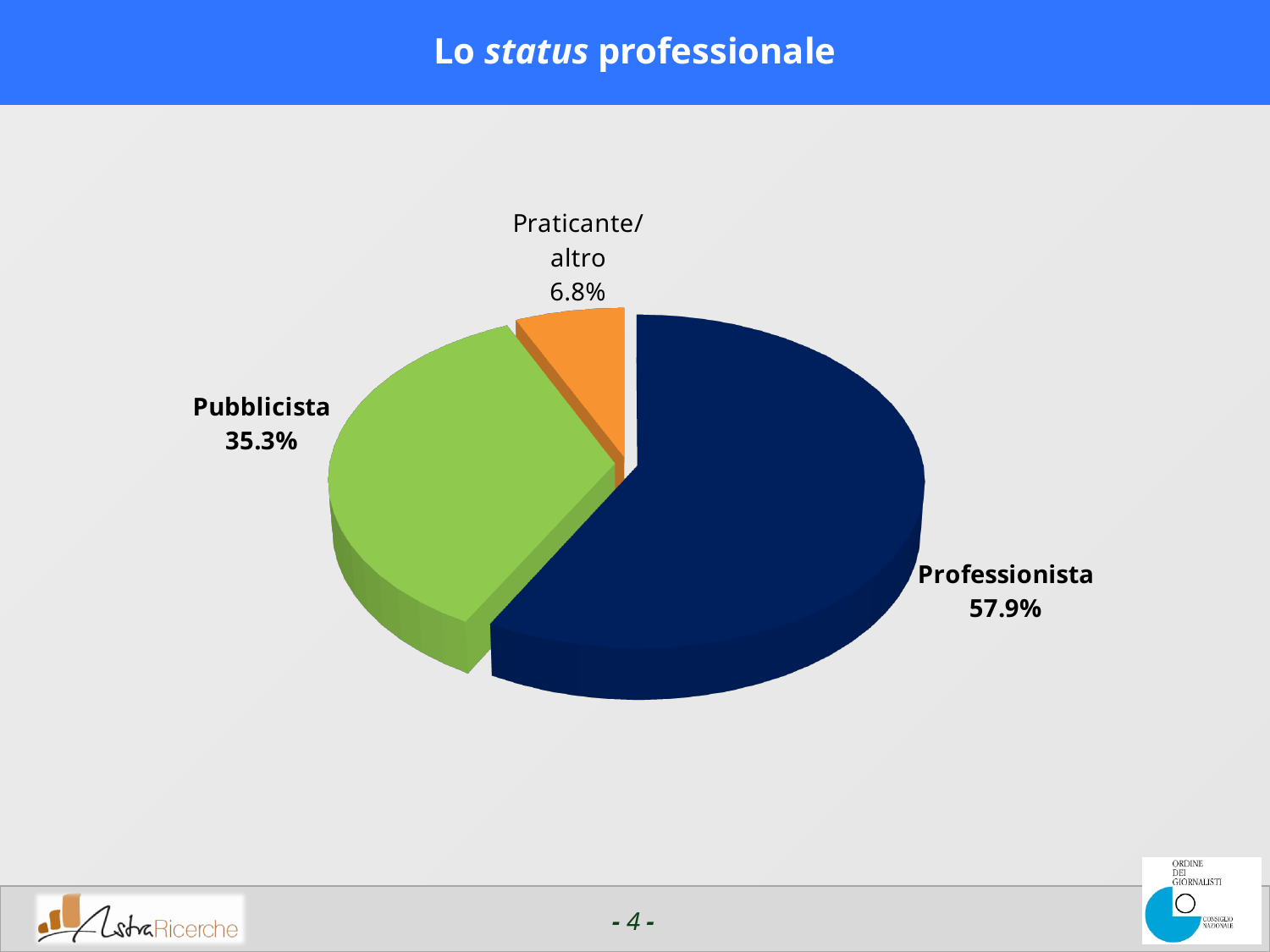
What is the share for Professionista? 57.9% What is the difference in percentage points between Pubblicista and Praticante/altro? 28.5 Which category has the smallest share of the pie? Praticante/altro Which is larger, the share for Pubblicista or the share for Praticante/altro? Pubblicista What kind of chart is shown on the slide? pie chart What is the title of the slide containing the chart? Lo status professionale What is the share for Pubblicista? 35.3% What is the difference in percentage points between Professionista and Pubblicista? 22.6 What colour is the Professionista slice? dark blue How many slices does the pie chart have? 3 Which category has the largest share of the pie? Professionista What is the share for Praticante/altro? 6.8%